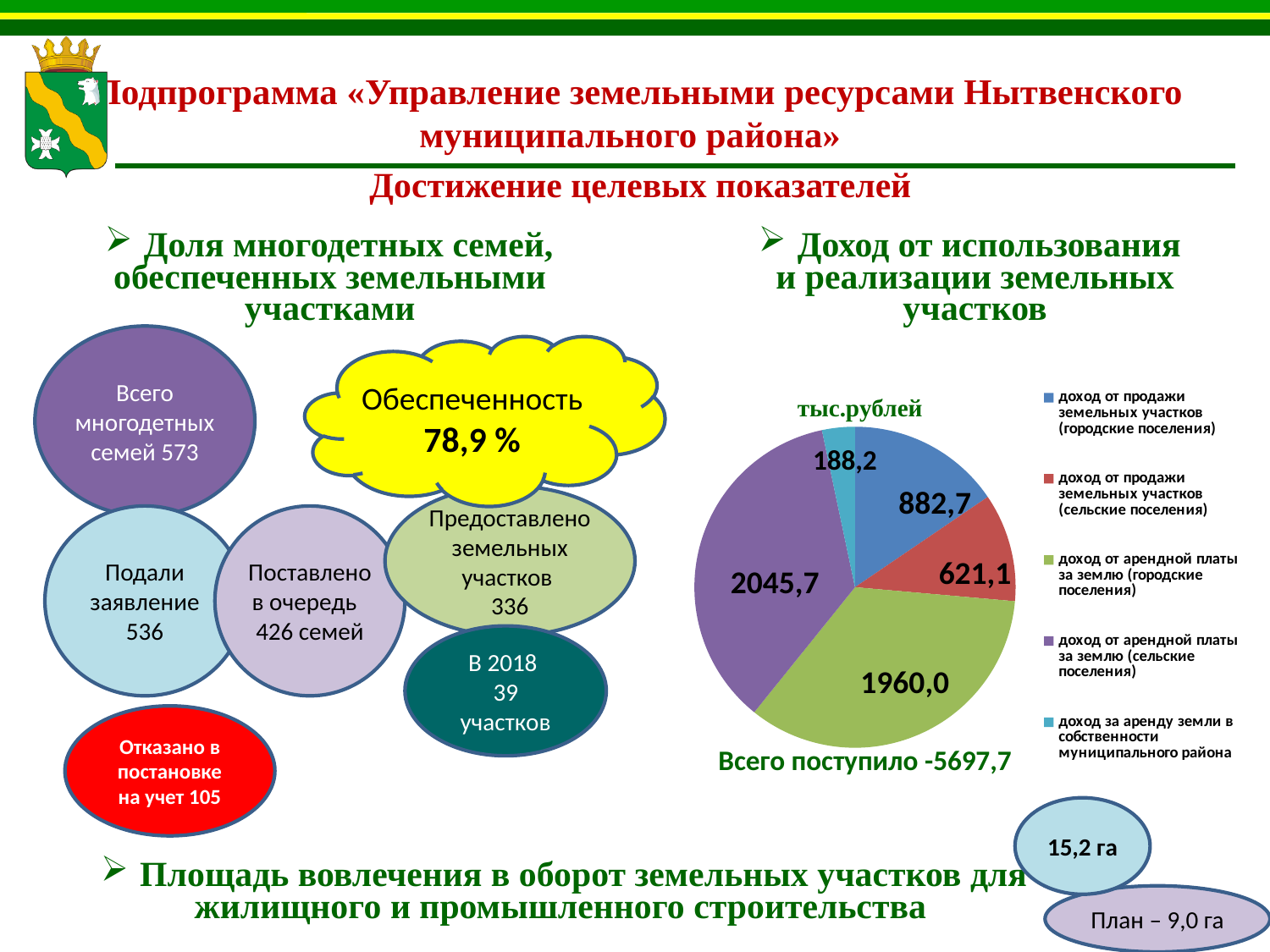
What is the value for "доход от продажи земельных участков (сельские поселения)" in the pie chart? 621,1 Which is larger: the value for "доход от продажи земельных участков (городские поселения)" or for "доход от продажи земельных участков (сельские поселения)"? доход от продажи земельных участков (городские поселения) How many slices does the pie chart have? 5 How many series does the legend of the pie chart list? 5 Which category has the smallest slice in the pie chart? доход за аренду земли в собственности муниципального района What kind of chart is shown on the slide? pie chart What is the value for "доход за аренду земли в собственности муниципального района" in the pie chart? 188,2 What is the value for "доход от продажи земельных участков (городские поселения)" in the pie chart? 882,7 What is the difference between the values for "доход от арендной платы за землю (сельские поселения)" and "доход от арендной платы за землю (городские поселения)"? 85,7 What is the value for "доход от арендной платы за землю (сельские поселения)" in the pie chart? 2045,7 What unit label is shown above the pie chart? тыс.рублей Which category has the largest slice in the pie chart? доход от арендной платы за землю (сельские поселения)